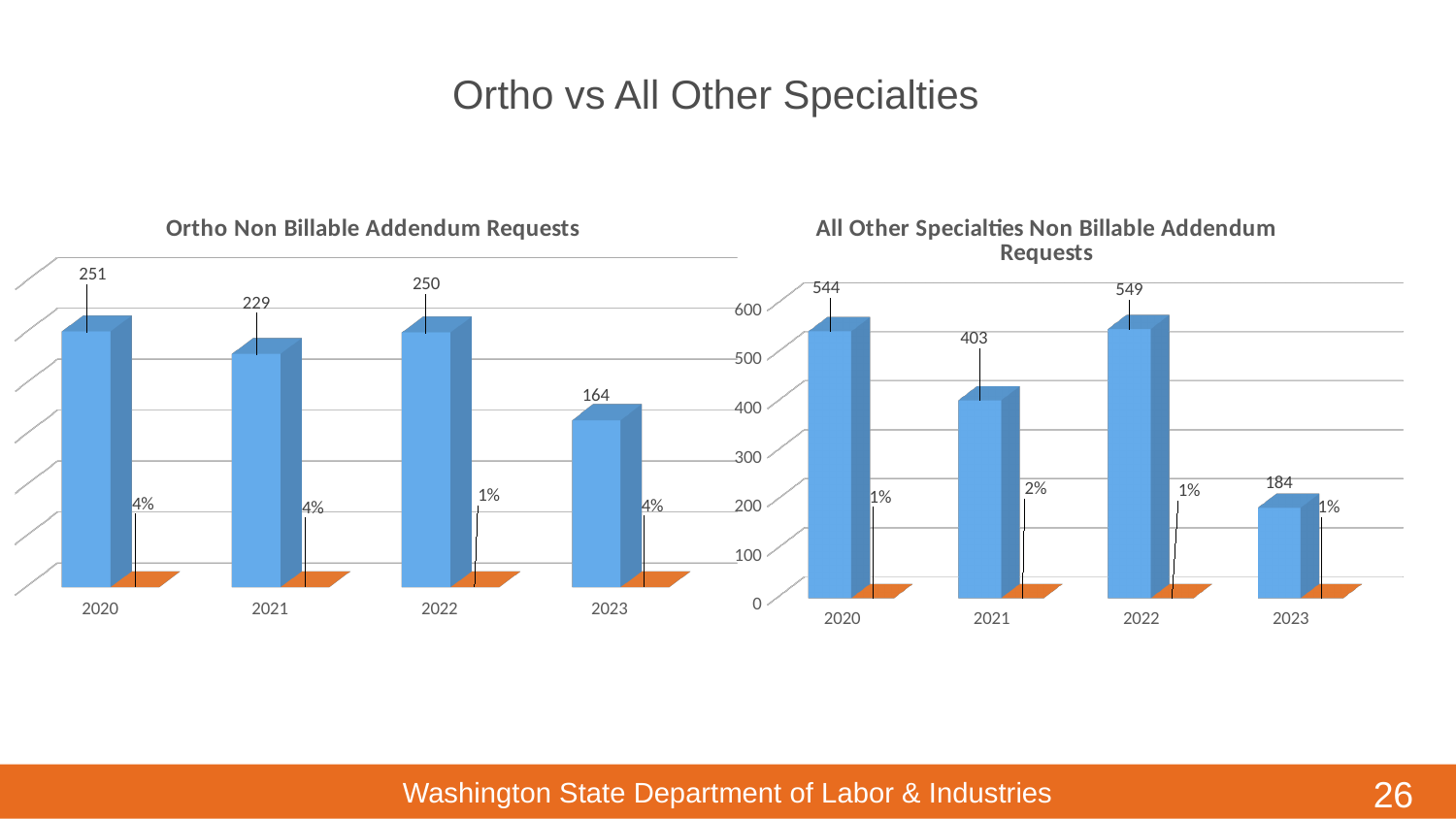
In the All Other Specialties Non Billable Addendum Requests chart, what is the value for 2021? 403 In the Ortho Non Billable Addendum Requests chart, what is the value for 2020? 251 In the Ortho Non Billable Addendum Requests chart, which year has the lowest number of requests? 2023 In the Ortho Non Billable Addendum Requests chart, what is the difference between the 2022 and 2023 values? 86 In the All Other Specialties Non Billable Addendum Requests chart, is the value for 2023 greater or less than 200? less In the Ortho Non Billable Addendum Requests chart, what is the value for 2023? 164 Which is larger: the 2021 value in the Ortho chart or the 2021 value in the All Other Specialties chart? All Other Specialties (403) In the All Other Specialties Non Billable Addendum Requests chart, what percentage is shown for 2021? 2% In the All Other Specialties Non Billable Addendum Requests chart, which year has the lowest number of requests? 2023 How many years are shown on the x axis of the Ortho Non Billable Addendum Requests chart? 4 In the All Other Specialties Non Billable Addendum Requests chart, what is the difference between the 2020 and 2021 values? 141 What type of chart is the All Other Specialties Non Billable Addendum Requests chart? Bar chart